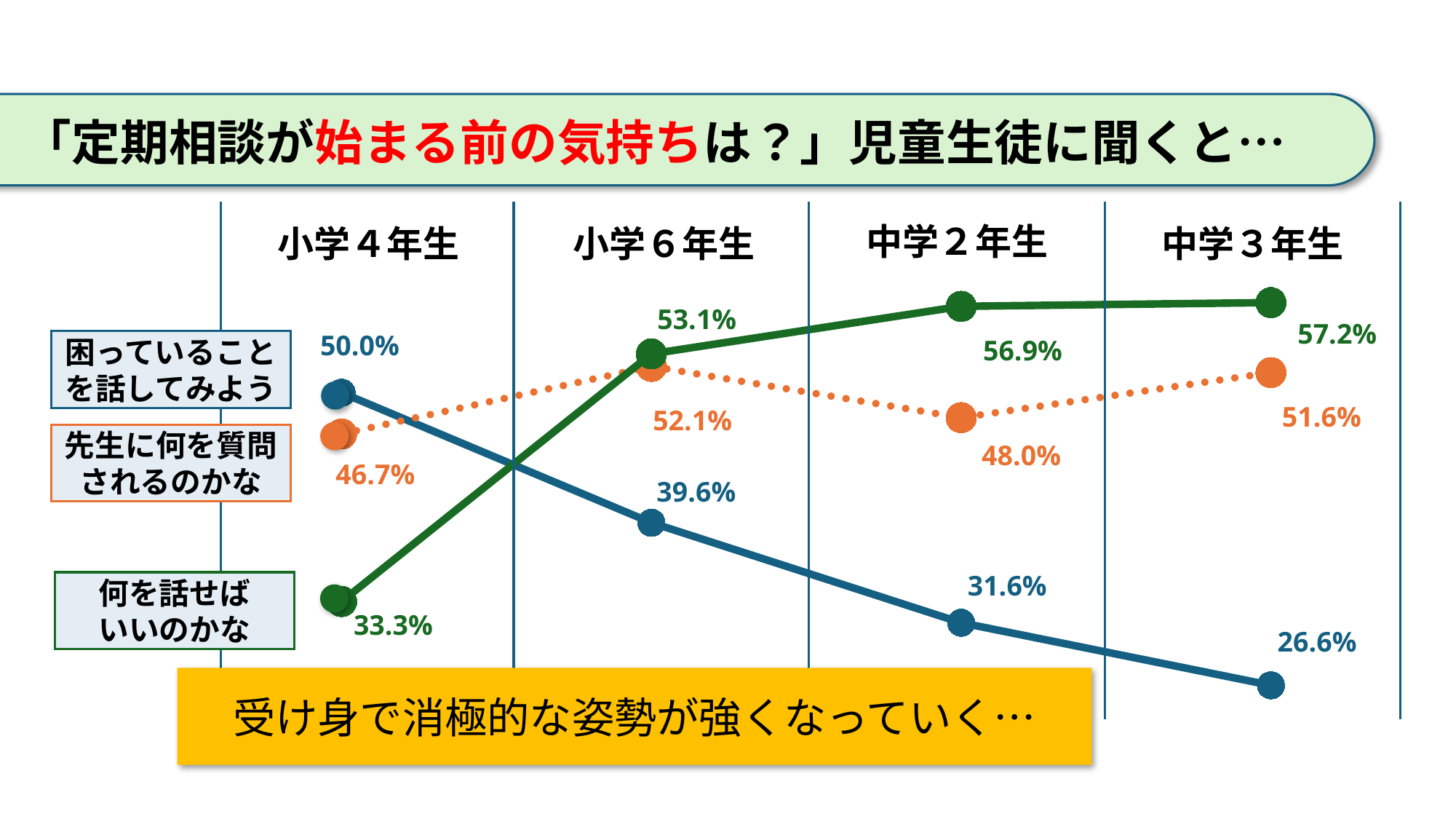
What is the value for 困っていることを話してみよう at 小学４年生? 50.0% What is the value for 何を話せばいいのかな at 中学３年生? 57.2% What is the difference between the 小学４年生 and 中学３年生 values for 困っていることを話してみよう? 23.4% How many grade categories are shown on the x axis? 4 What is the value for 困っていることを話してみよう at 小学６年生? 39.6% What kind of chart is this? line chart How many series does the chart show? 3 At which grade is the value for 何を話せばいいのかな lowest? 小学４年生 What is the value for 先生に何を質問されるのかな at 中学２年生? 48.0% Which is larger at 小学４年生: 困っていることを話してみよう or 何を話せばいいのかな? 困っていることを話してみよう At which grade is the value for 困っていることを話してみよう lowest? 中学３年生 Does the value for 困っていることを話してみよう rise or fall from 小学４年生 to 中学３年生? fall